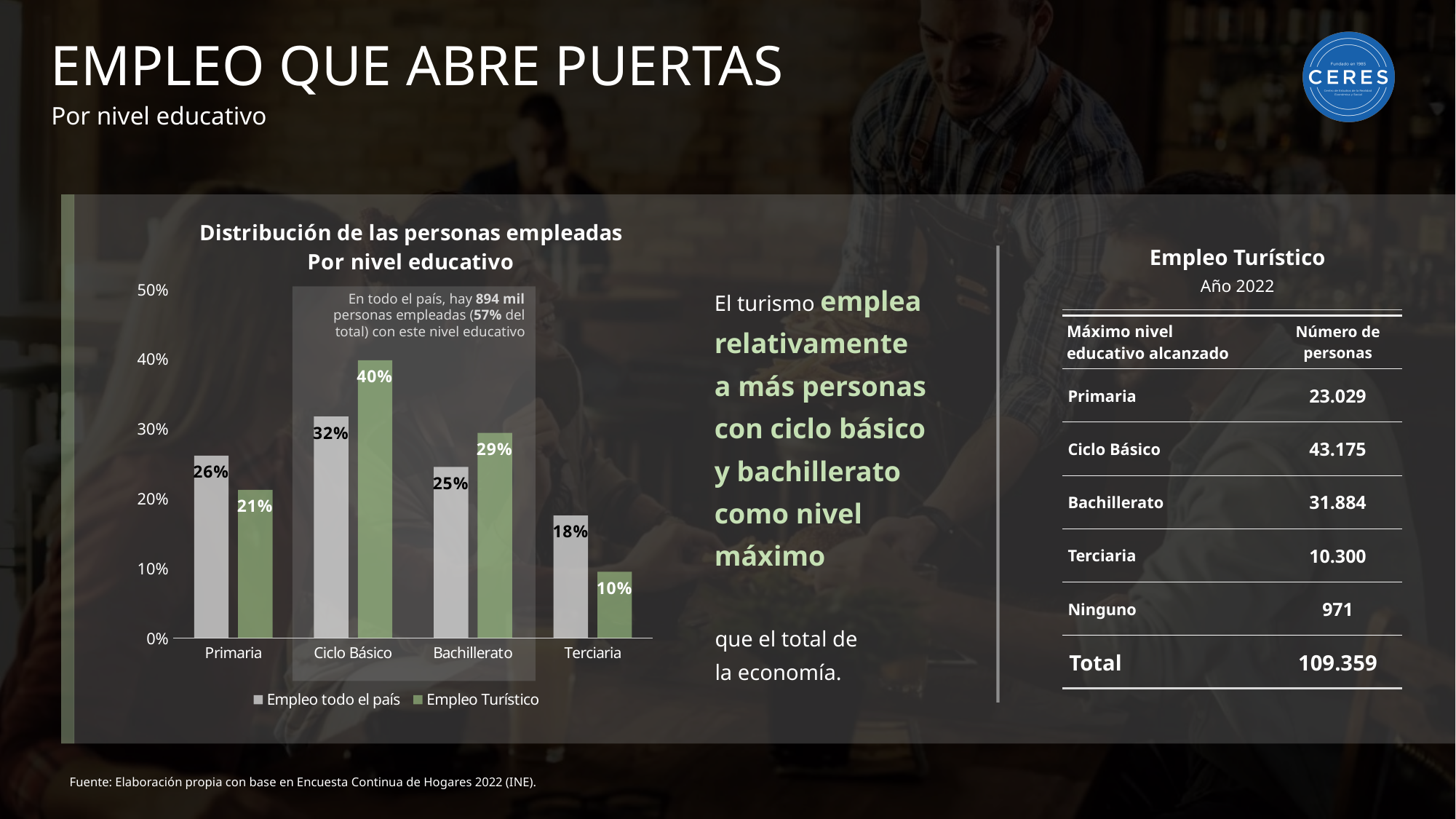
What colour are the bars for the Empleo Turístico series? Green How many series does the chart legend list? 2 Is the value for Empleo todo el país in the Terciaria category greater or less than 20%? less Which category has the lowest value for Empleo todo el país? Terciaria What is the difference between Empleo Turístico and Empleo todo el país in the Ciclo Básico category? 8 percentage points What is the value for Empleo Turístico in the Ciclo Básico category? 40% In the Bachillerato category, which series has the larger value, Empleo todo el país or Empleo Turístico? Empleo Turístico What is the value for Empleo Turístico in the Terciaria category? 10% What is the value for Empleo todo el país in the Primaria category? 26% Which category has the highest value for Empleo Turístico? Ciclo Básico How many education-level categories are shown on the x axis of the chart? 4 What kind of chart is shown on the slide? Bar chart